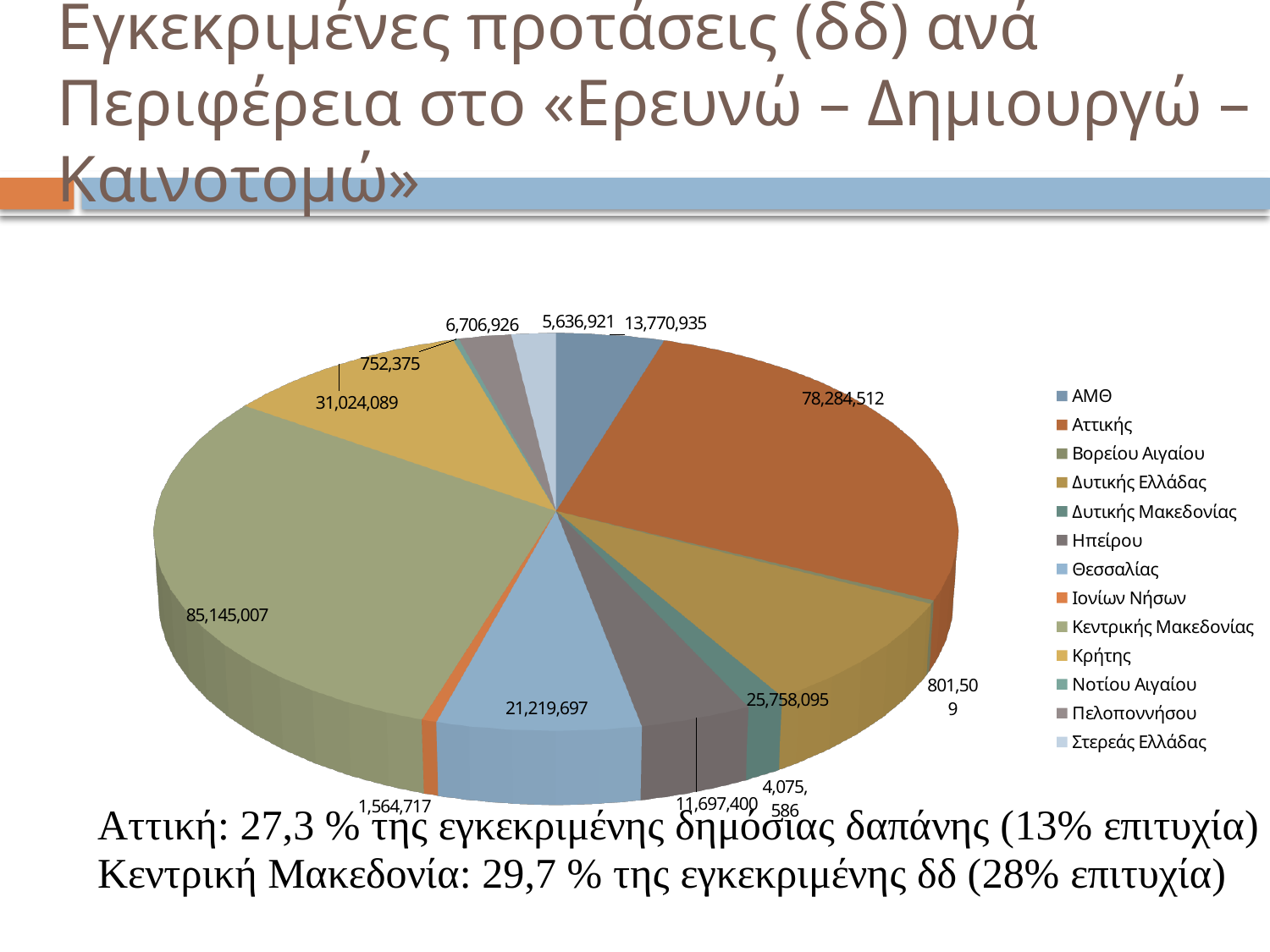
What colour is the slice for Αττικής in the pie chart? Orange Which region has the largest slice of the pie? Κεντρικής Μακεδονίας What is the value for Αττικής? 78,284,512 What is the value for Κεντρικής Μακεδονίας? 85,145,007 What is the difference between the values for Κεντρικής Μακεδονίας and Αττικής? 6,860,495 What is the value for Θεσσαλίας? 21,219,697 Which region has the smallest value in the pie chart? Νοτίου Αιγαίου How many regions (slices) does the pie chart show? 13 What kind of chart is shown on the slide? Pie chart According to the slide, what share of the approved public expenditure does Αττική account for? 27,3 % Which is larger, the value for Κρήτης or the value for Δυτικής Ελλάδας? Κρήτης What is the value for Κρήτης? 31,024,089